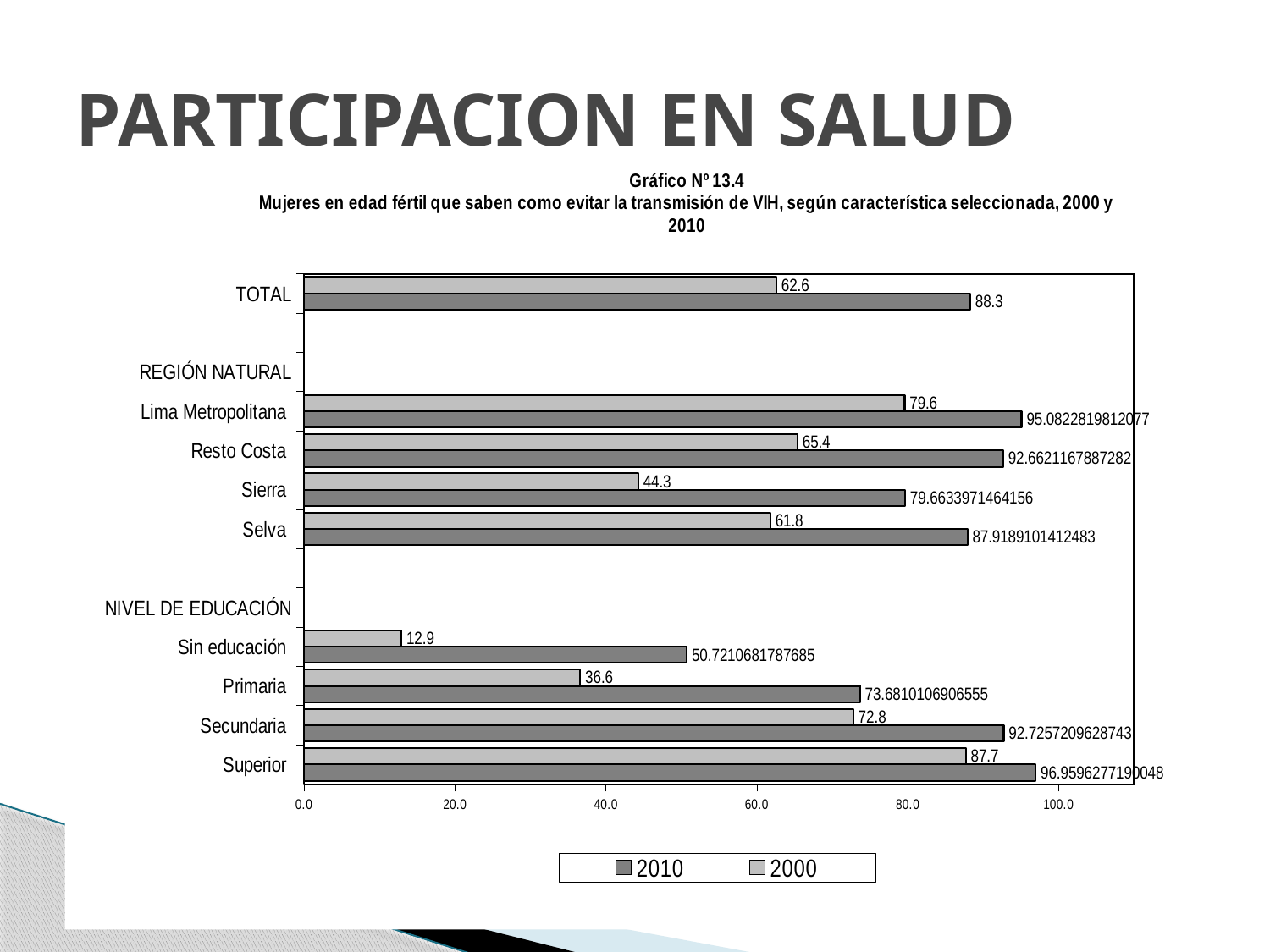
How many series does the legend list? 2 Which category has the lowest 2000 value? Sin educación What is the 2000 value for TOTAL? 62.6 What is the 2000 value for Sierra? 44.3 What is the 2000 value for Superior? 87.7 Which category has the highest 2000 value? Superior What is the 2010 value for TOTAL? 88.3 What kind of chart is shown on the slide? Bar chart Which is larger, the 2000 value for Lima Metropolitana or the 2000 value for Resto Costa? Lima Metropolitana Is the 2010 value for Primaria greater or less than 60.0? greater What is the 2010 value for Sin educación? 50.7210681787685 What is the difference between the 2010 and 2000 values for TOTAL? 25.7